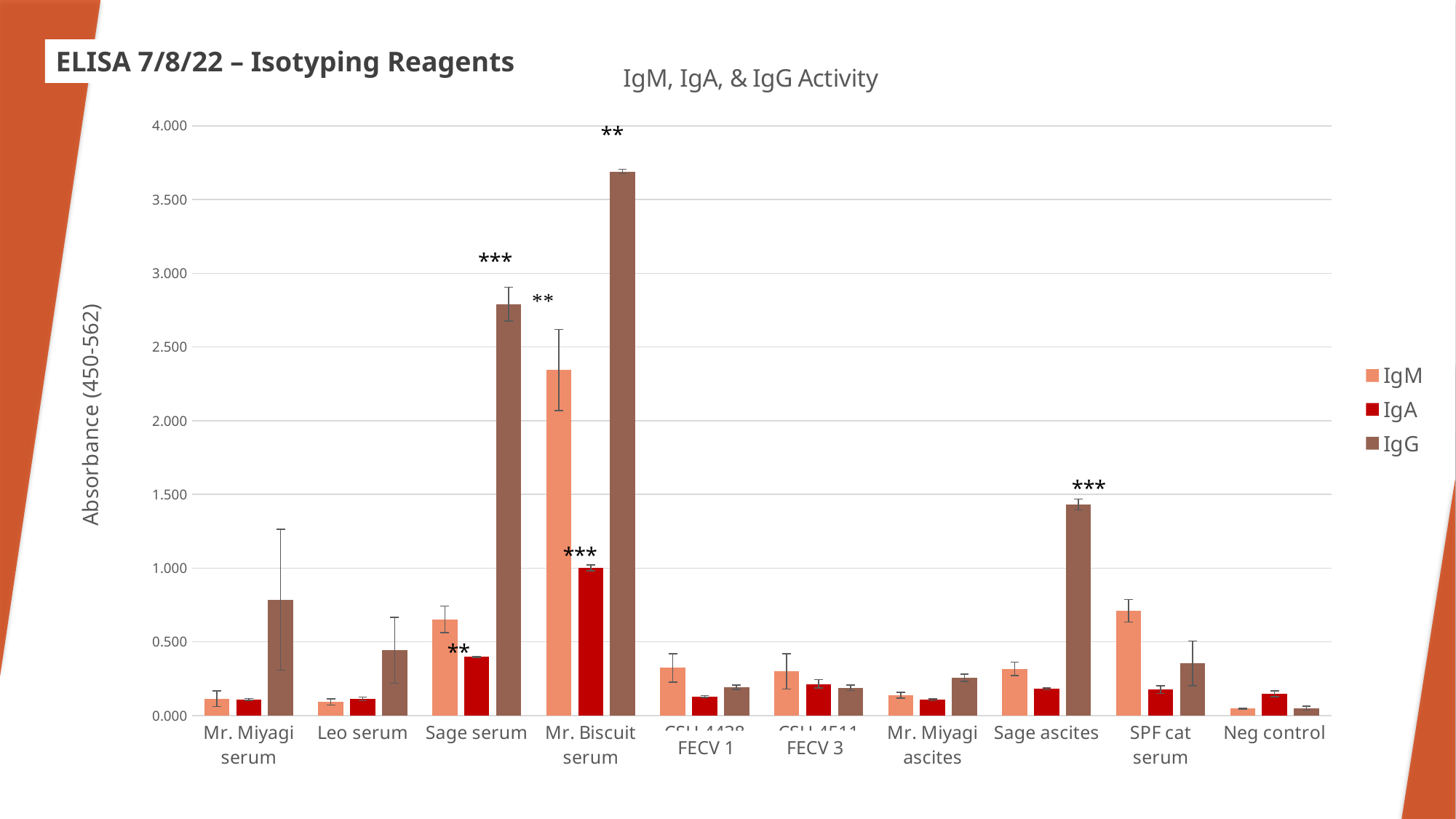
Is the IgG value for Sage serum greater or less than 2.500? greater Is the IgG value for Mr. Biscuit serum greater or less than 3.500? greater Which sample has the highest IgG bar? Mr. Biscuit serum Which sample has the lowest IgG bar? Neg control Is the IgM value for Mr. Biscuit serum greater or less than 2.000? greater For Mr. Biscuit serum, which is larger, the IgM value or the IgA value? IgM How many sample categories are shown along the x axis? 10 For Sage serum, which is larger, the IgG value or the IgM value? IgG How many series does the legend list? 3 What kind of chart is shown on the slide? bar chart What is the label on the vertical axis of the chart? Absorbance (450-562)